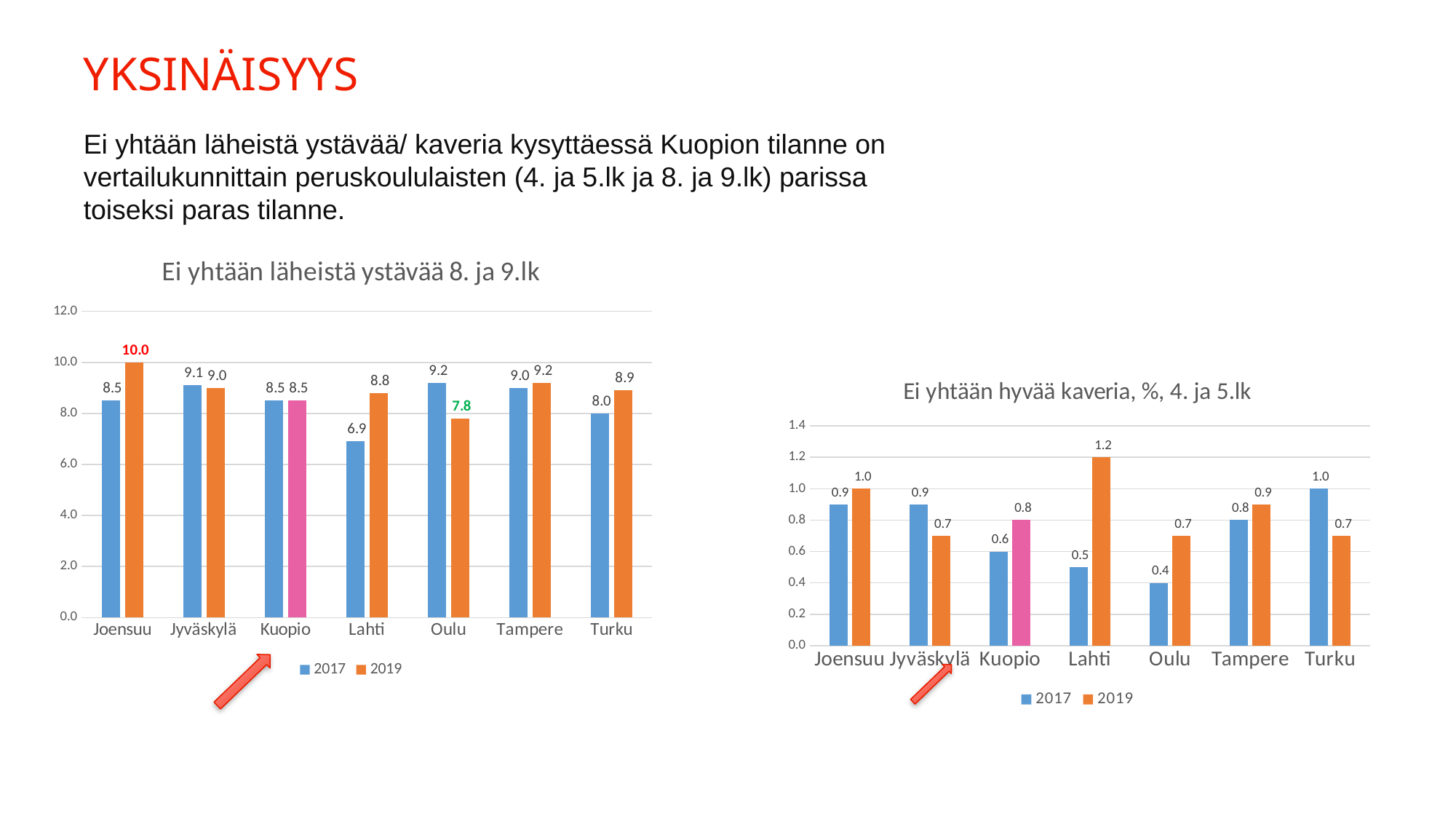
In the chart 'Ei yhtään hyvää kaveria, %, 4. ja 5.lk', which city has the lowest 2017 value? Oulu What type of chart is 'Ei yhtään hyvää kaveria, %, 4. ja 5.lk'? Bar chart In the chart 'Ei yhtään hyvää kaveria, %, 4. ja 5.lk', what is the 2019 value for Lahti? 1.2 In the chart 'Ei yhtään läheistä ystävää 8. ja 9.lk', what is the difference between the 2019 and 2017 values for Lahti? 1.9 In the chart 'Ei yhtään hyvää kaveria, %, 4. ja 5.lk', what is the difference between the 2019 and 2017 values for Kuopio? 0.2 In the chart 'Ei yhtään läheistä ystävää 8. ja 9.lk', what is the 2017 value for Lahti? 6.9 In the chart 'Ei yhtään läheistä ystävää 8. ja 9.lk', which city has the highest 2019 value? Joensuu How many cities are shown in the chart 'Ei yhtään läheistä ystävää 8. ja 9.lk'? 7 In the chart 'Ei yhtään läheistä ystävää 8. ja 9.lk', is the 2017 value for Oulu larger or the 2019 value? 2017 In the chart 'Ei yhtään läheistä ystävää 8. ja 9.lk', what is the 2019 value for Joensuu? 10.0 How many series does the legend list in the chart 'Ei yhtään hyvää kaveria, %, 4. ja 5.lk'? 2 In the chart 'Ei yhtään läheistä ystävää 8. ja 9.lk', which city has the lowest 2017 value? Lahti